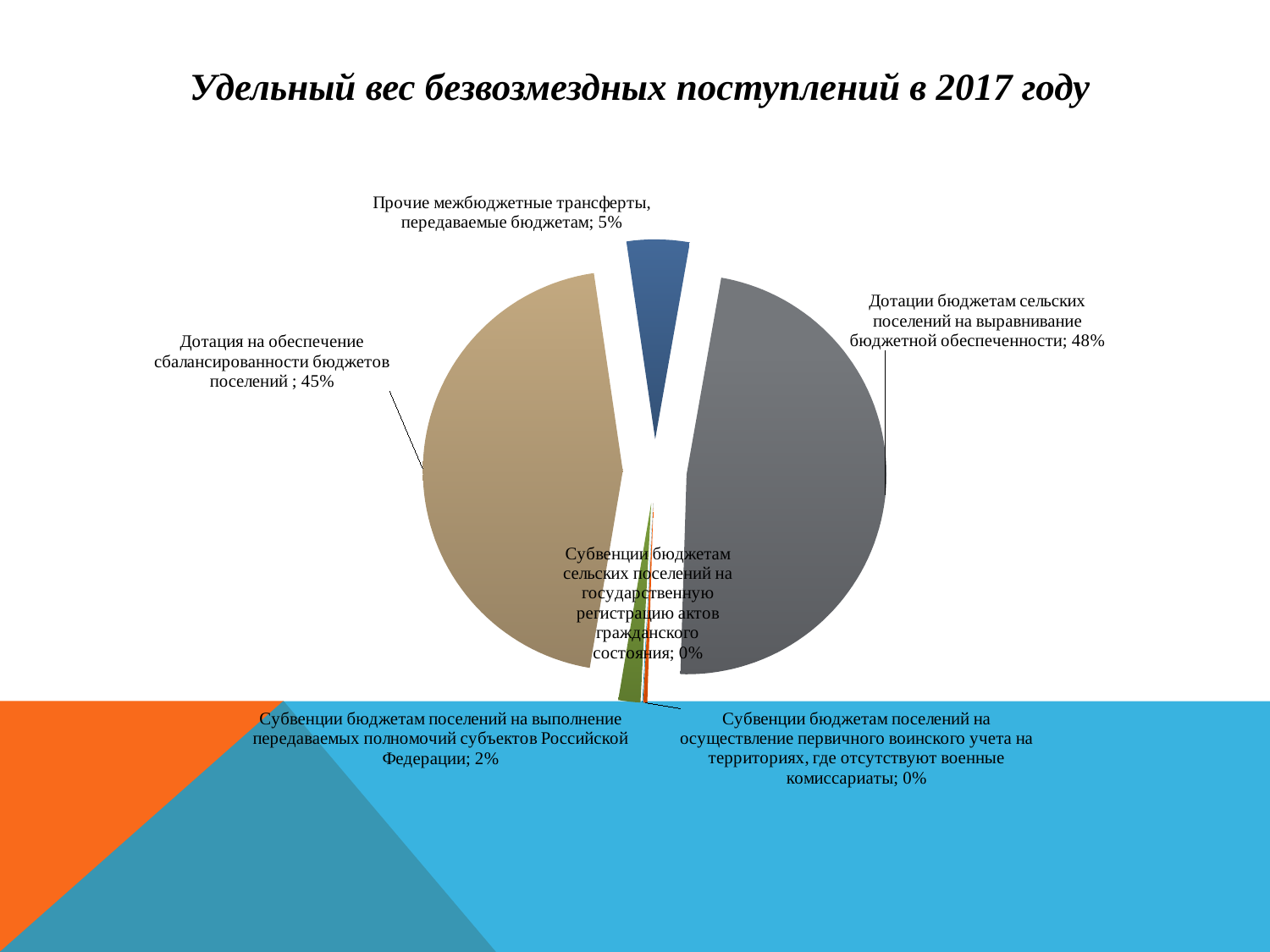
What is the difference in percentage points between the share of "Дотации бюджетам сельских поселений на выравнивание бюджетной обеспеченности" and "Дотация на обеспечение сбалансированности бюджетов поселений"? 3 percentage points What is the title of the chart on the slide? Удельный вес безвозмездных поступлений в 2017 году What share is shown for "Субвенции бюджетам поселений на осуществление первичного воинского учета на территориях, где отсутствуют военные комиссариаты"? 0% What colour is the slice for "Прочие межбюджетные трансферты, передаваемые бюджетам"? Blue What share does "Дотация на обеспечение сбалансированности бюджетов поселений" have in the pie chart? 45% Which is larger: the share of "Прочие межбюджетные трансферты, передаваемые бюджетам" or the share of "Субвенции бюджетам поселений на выполнение передаваемых полномочий субъектов Российской Федерации"? Прочие межбюджетные трансферты, передаваемые бюджетам What share does "Прочие межбюджетные трансферты, передаваемые бюджетам" have in the pie chart? 5% How many slices does the pie chart have? 6 Which category has the largest share in the pie chart? Дотации бюджетам сельских поселений на выравнивание бюджетной обеспеченности What kind of chart is shown on the slide? Pie chart